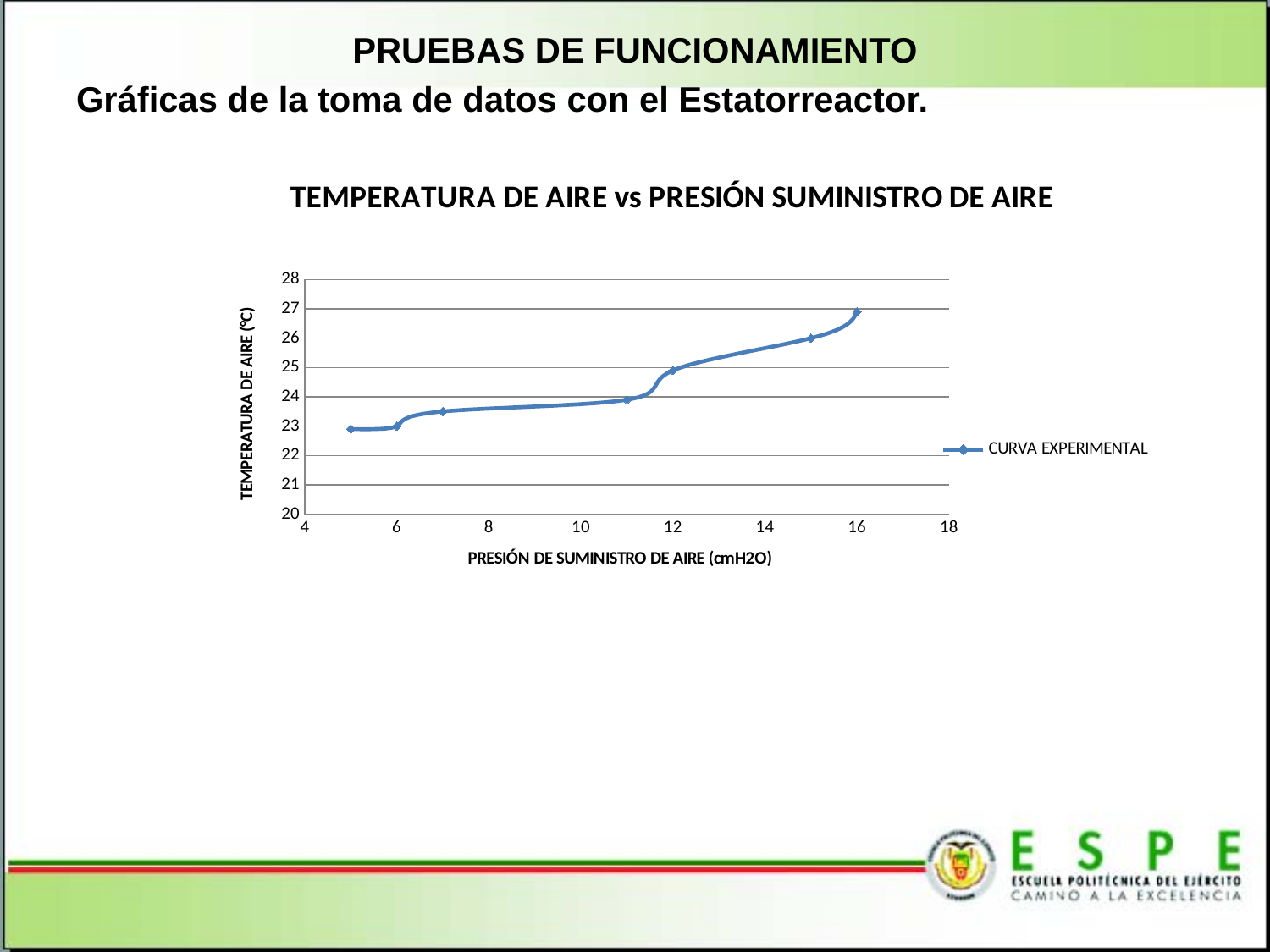
What is the name of the series shown in the legend? CURVA EXPERIMENTAL What is the title of the chart? TEMPERATURA DE AIRE vs PRESIÓN SUMINISTRO DE AIRE How many series does the legend list? 1 How many data points are plotted on the CURVA EXPERIMENTAL line? 7 Is the temperature at a supply pressure of 16 greater or less than 26? greater Is the temperature at a supply pressure of 15 greater or less than 25? greater Which has the higher air temperature: a supply pressure of 12 or a supply pressure of 7? 12 What kind of chart is shown on the slide? line chart Does the air temperature rise or fall as the supply pressure increases along the x axis? rise At which supply pressure value is the air temperature highest? 16 Is the temperature at a supply pressure of 12 greater or less than 24? greater